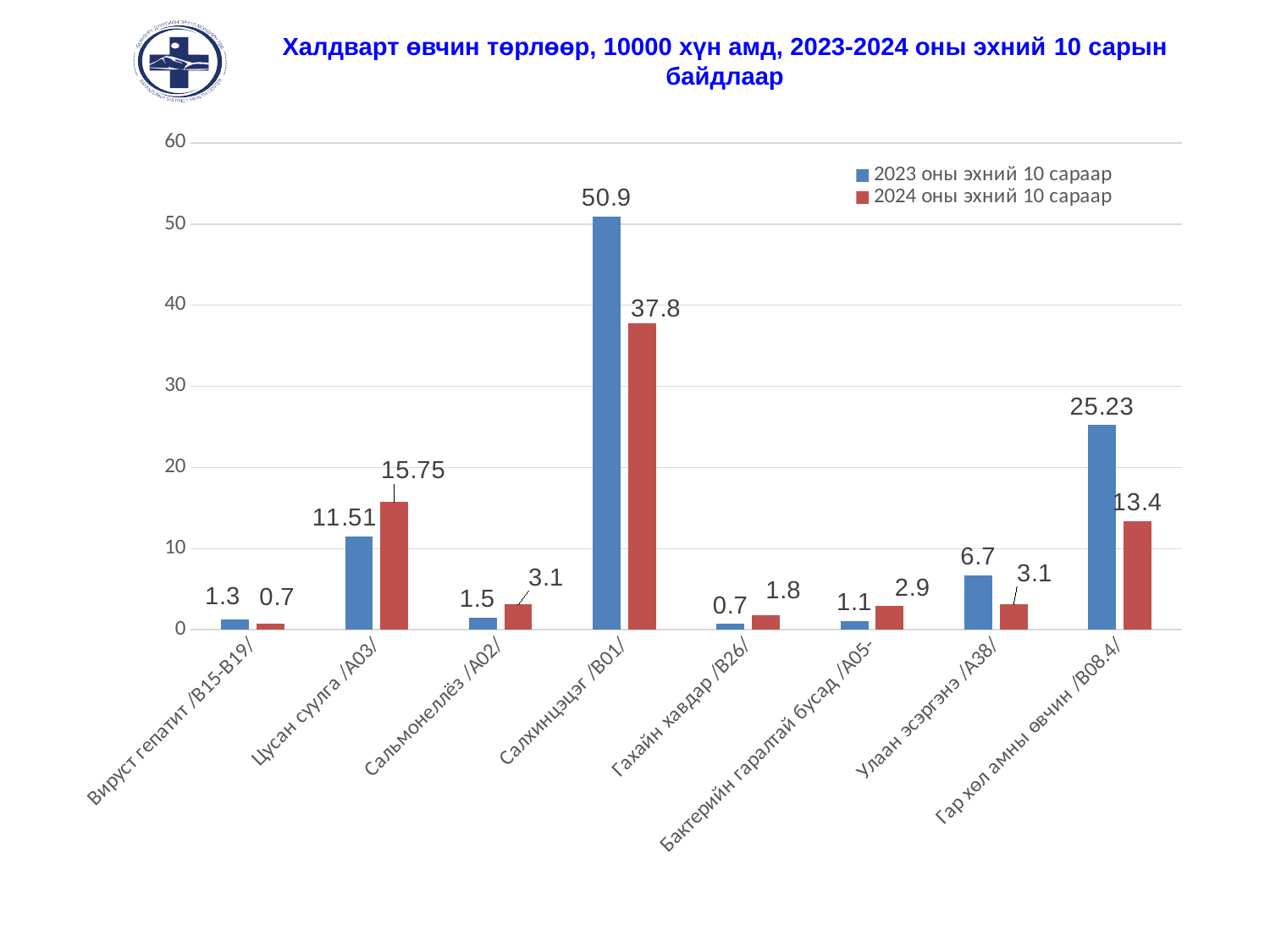
Which category has the lowest value in the 2023 оны эхний 10 сараар series? Гахайн хавдар /B26/ What is the value for Цусан суулга /A03/ in the 2024 оны эхний 10 сараар series? 15.75 What is the value for Гар хөл амны өвчин /B08.4/ in the 2023 оны эхний 10 сараар series? 25.23 How many categories are shown on the x axis? 8 What is the difference between the 2023 and 2024 values for Салхинцэцэг /B01/? 13.1 Which category has the highest value in the 2024 оны эхний 10 сараар series? Салхинцэцэг /B01/ What is the difference between the 2024 and 2023 values for Цусан суулга /A03/? 4.24 For Улаан эсэргэнэ /A38/, which series has the larger value, 2023 оны эхний 10 сараар or 2024 оны эхний 10 сараар? 2023 оны эхний 10 сараар How many series does the legend list? 2 What kind of chart is shown on the slide? bar chart What is the value for Салхинцэцэг /B01/ in the 2023 оны эхний 10 сараар series? 50.9 Is the 2024 оны эхний 10 сараар value for Салхинцэцэг /B01/ greater or less than 40? less